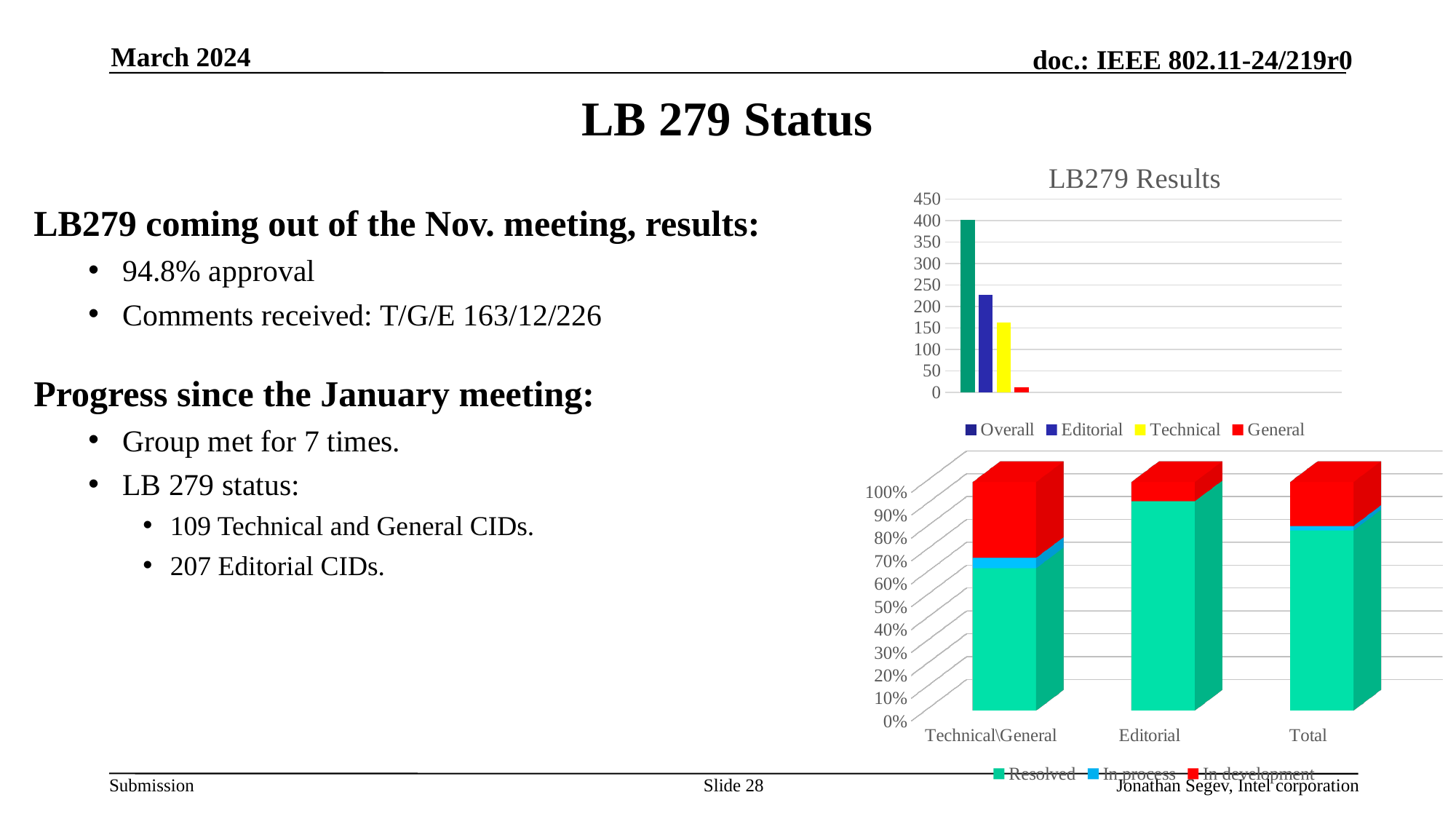
What kind of chart is the top chart titled "LB279 Results"? bar chart How many categories are shown on the x axis of the bottom stacked bar chart? 3 In the top chart "LB279 Results", which is larger, the Editorial bar or the Technical bar? Editorial How many series does the legend of the top chart "LB279 Results" list? 4 In the bottom stacked bar chart, which category has the largest Resolved share? Editorial What is the title of the top chart on the slide? LB279 Results How many series does the legend of the bottom stacked bar chart list? 3 In the top chart "LB279 Results", which series has the shortest bar? General In the top chart "LB279 Results", is the value for Technical greater or less than 200? less In the top chart "LB279 Results", which series has the tallest bar? Overall In the top chart "LB279 Results", is the value for Overall greater or less than 350? greater In the top chart "LB279 Results", is the value for General greater or less than 50? less